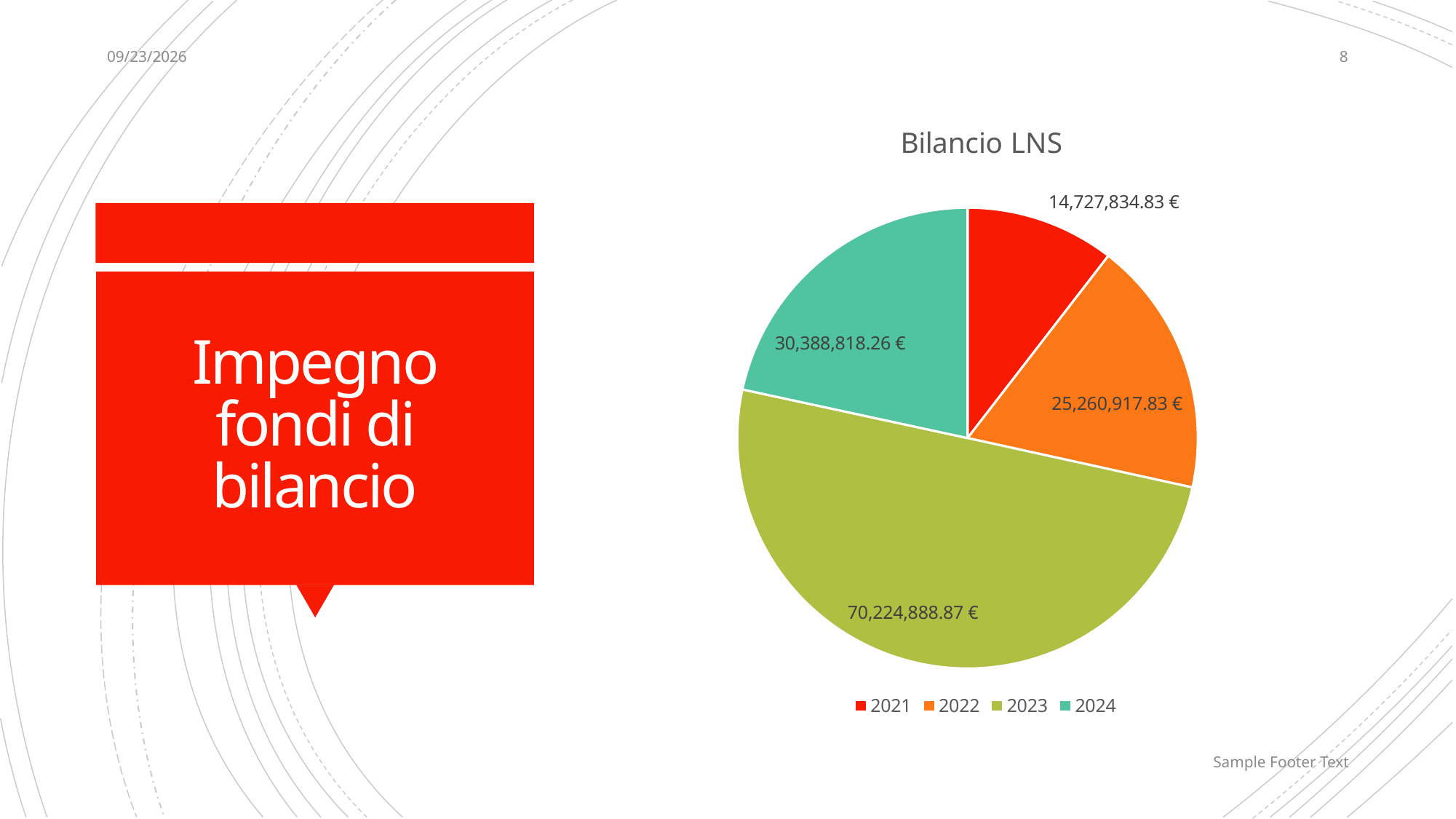
What is the value for 2022 in the Bilancio LNS chart? 25,260,917.83 € Which colour represents 2024 in the Bilancio LNS chart legend? Teal What is the value for 2023 in the Bilancio LNS chart? 70,224,888.87 € How many slices does the Bilancio LNS pie chart have? 4 What is the value for 2024 in the Bilancio LNS chart? 30,388,818.26 € What type of chart is shown on the slide? Pie chart What is the title of the chart? Bilancio LNS What is the value for 2021 in the Bilancio LNS chart? 14,727,834.83 € What is the difference between the values for 2023 and 2022 in the Bilancio LNS chart? 44,963,971.04 € Which is larger in the Bilancio LNS chart, the value for 2022 or the value for 2024? 2024 Which year has the largest slice in the Bilancio LNS chart? 2023 Which year has the smallest slice in the Bilancio LNS chart? 2021